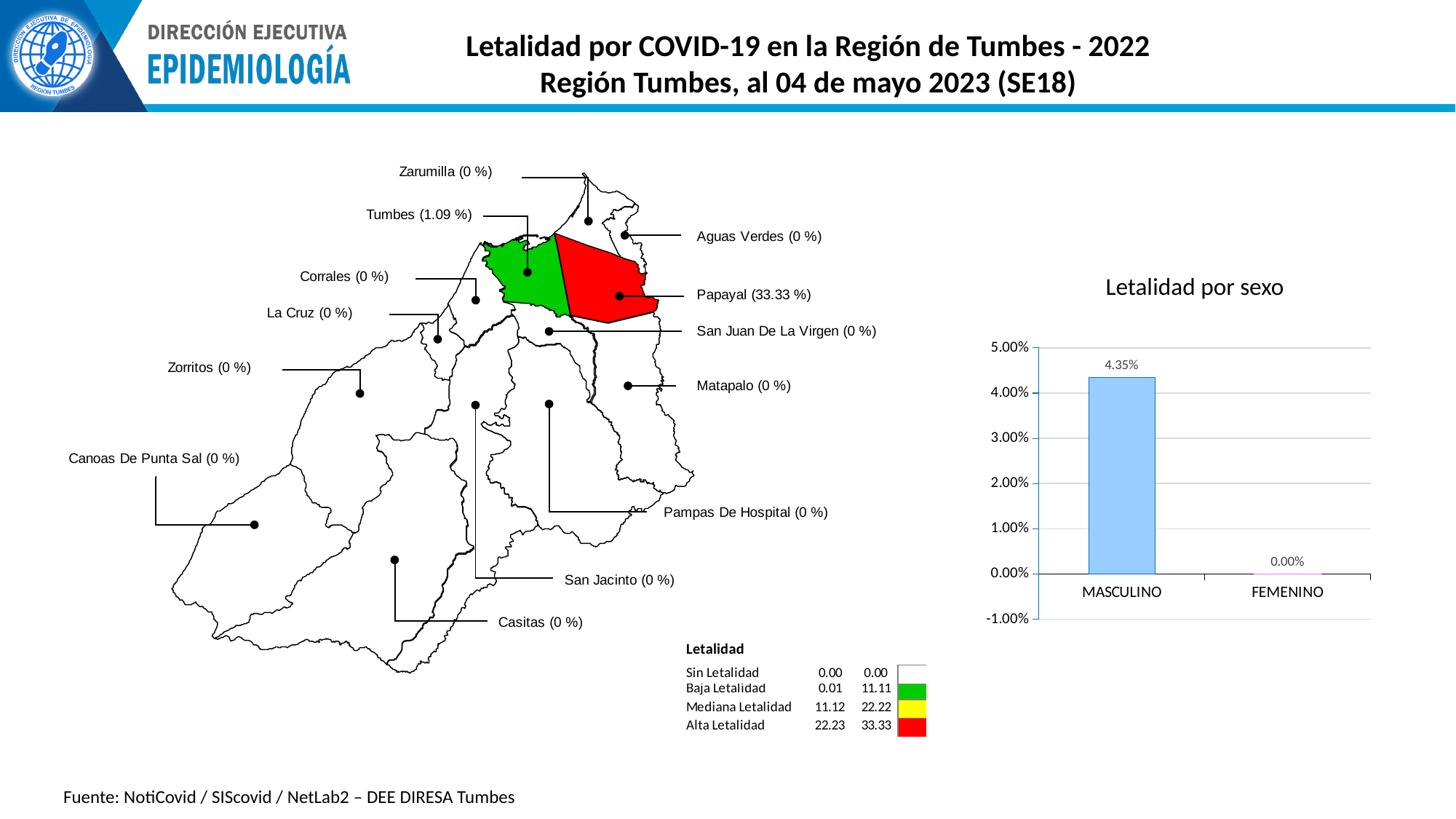
In the 'Letalidad por sexo' chart, what is the value for FEMENINO? 0.00% In the 'Letalidad por sexo' chart, which category has the highest value? MASCULINO On the map of the Tumbes region, what is the lethality value shown for Papayal? 33.33 % How many categories are shown in the 'Letalidad por sexo' chart? 2 In the 'Letalidad por sexo' chart, what is the difference between the MASCULINO and FEMENINO values? 4.35% On the map of the Tumbes region, what is the lethality value shown for Tumbes? 1.09 % In the 'Letalidad por sexo' chart, is the value for MASCULINO greater or less than 4.00%? greater In the 'Letalidad por sexo' chart, what is the highest value shown on the vertical axis? 5.00% In the 'Letalidad por sexo' chart, what is the value for MASCULINO? 4.35% What is the title of the chart on the right side of the slide? Letalidad por sexo What kind of chart is 'Letalidad por sexo'? bar chart In the 'Letalidad por sexo' chart, which category has the lowest value? FEMENINO